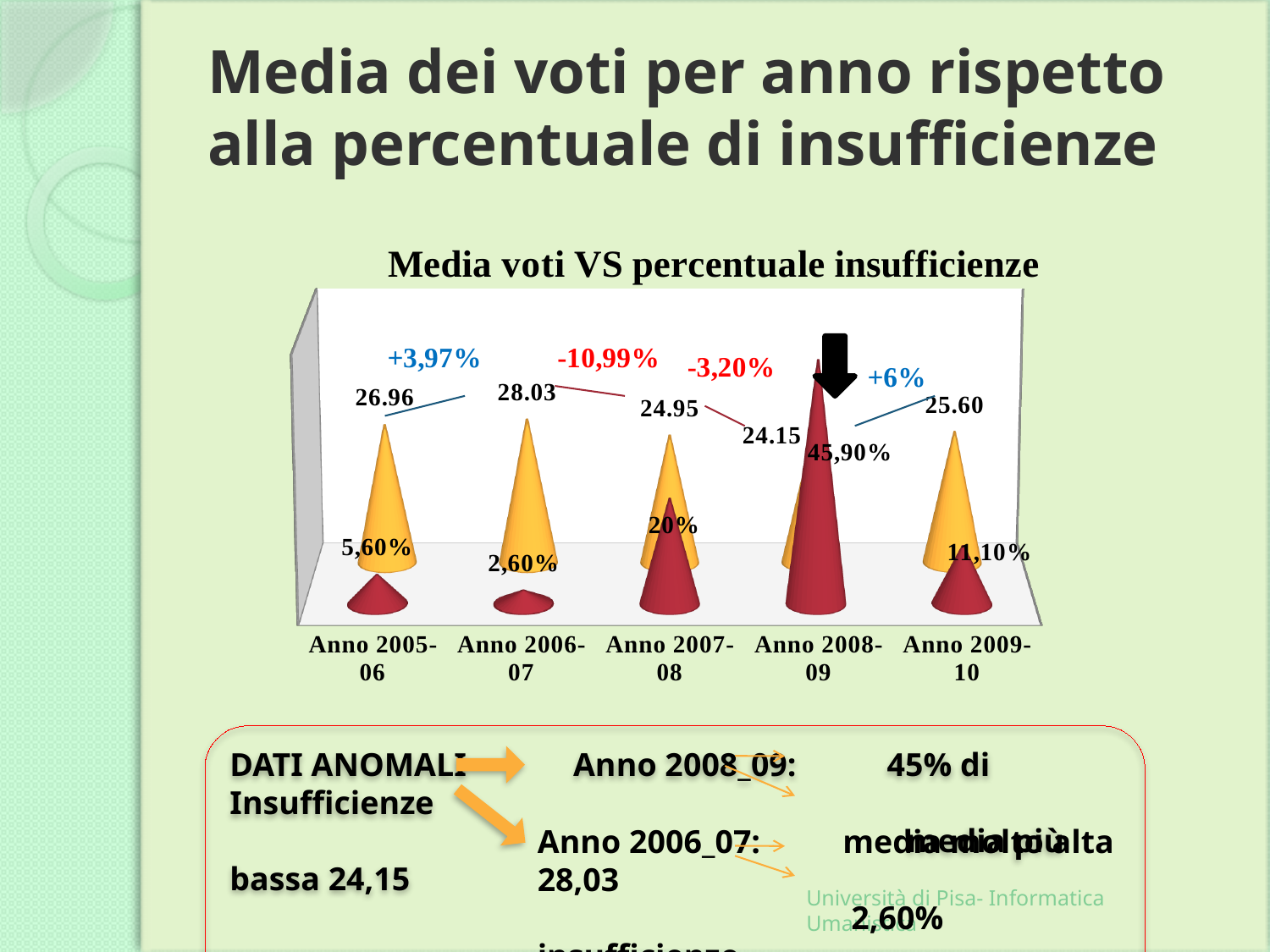
How many school years are shown on the x axis? 5 Which year has the highest media voti? Anno 2006-07 What is the percentage of insufficienze for Anno 2008-09? 45,90% Which is larger, the percentage of insufficienze for Anno 2007-08 or for Anno 2009-10? Anno 2007-08 Which year has the highest percentage of insufficienze? Anno 2008-09 Which year has the lowest media voti? Anno 2008-09 What kind of chart is shown on the slide? Bar chart What is the title of the chart? Media voti VS percentuale insufficienze What is the media voti value for Anno 2009-10? 25.60 What is the percentage of insufficienze for Anno 2006-07? 2,60% What is the difference between the media voti of Anno 2006-07 and Anno 2005-06? 1.07 What is the media voti value for Anno 2006-07? 28.03